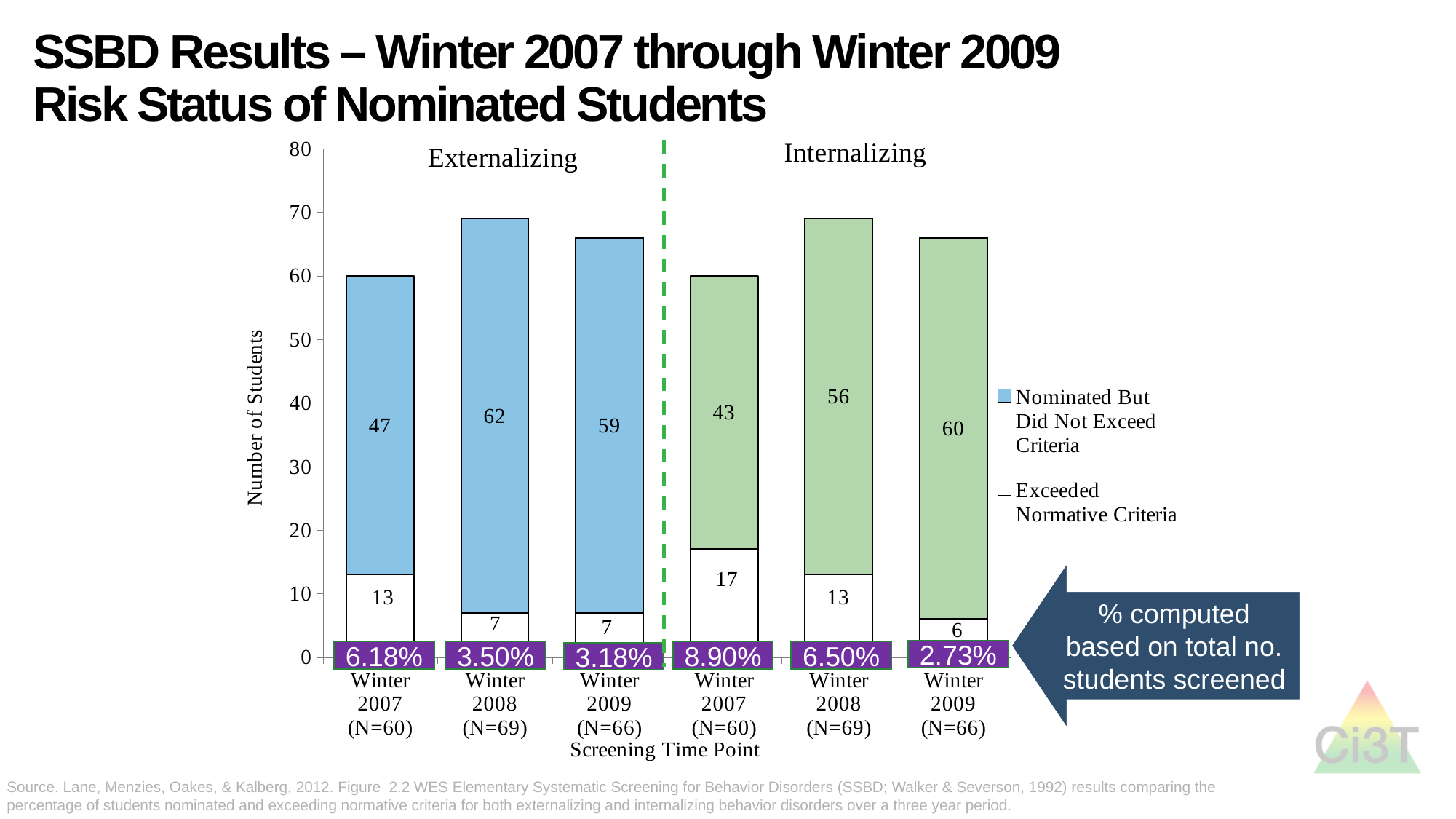
Which bar has the highest Exceeded Normative Criteria value? Internalizing Winter 2007 What is the Nominated But Did Not Exceed Criteria value for Internalizing Winter 2008? 56 How many series does the legend list? 2 What is the total of the stacked bar for Externalizing Winter 2008? 69 How many bars are plotted in the chart? 6 What is the Exceeded Normative Criteria value for Externalizing Winter 2007? 13 Which bar has the lowest Exceeded Normative Criteria value? Internalizing Winter 2009 Which is larger: the Exceeded Normative Criteria value for Internalizing Winter 2008 or for Externalizing Winter 2009? Internalizing Winter 2008 Do the percentages shown below the Internalizing bars rise or fall from Winter 2007 to Winter 2009? Fall What is the difference between the Nominated But Did Not Exceed Criteria values for Externalizing Winter 2008 and Externalizing Winter 2007? 15 What percentage is shown below the Internalizing Winter 2007 bar? 8.90% What kind of chart is shown on the slide? Stacked bar chart